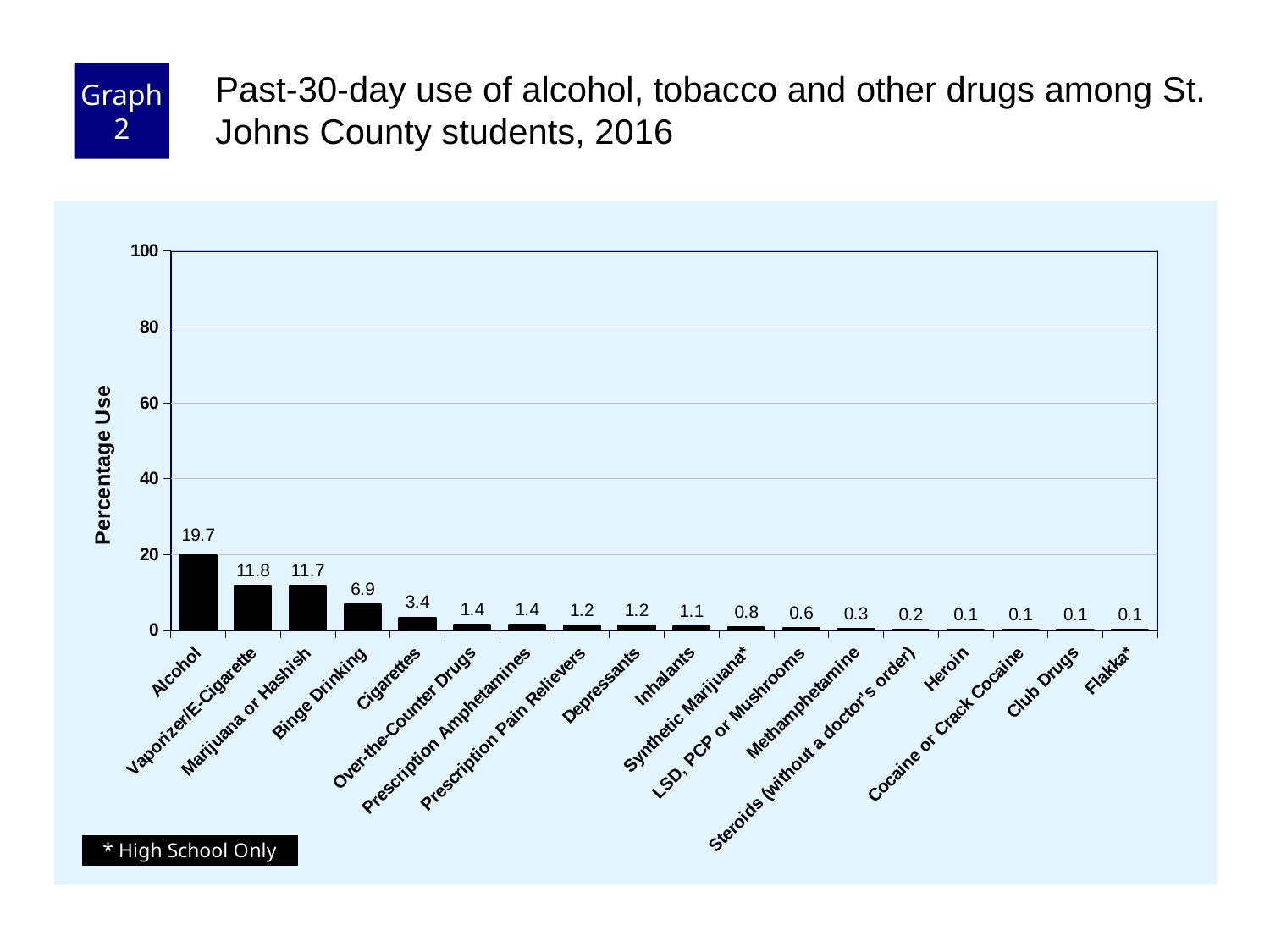
What is the percentage use for Cigarettes? 3.4 What is the difference in percentage use between Binge Drinking and Cigarettes? 3.5 What is the lowest percentage use value shown on the chart? 0.1 What is the percentage use for Binge Drinking? 6.9 How many categories are shown on the chart? 18 What is the percentage use for Alcohol? 19.7 What is the difference in percentage use between Alcohol and Vaporizer/E-Cigarette? 7.9 Which category has the highest percentage use? Alcohol Which has a higher percentage use, Marijuana or Hashish or Binge Drinking? Marijuana or Hashish What is the percentage use for Synthetic Marijuana? 0.8 What type of chart is shown on the slide? Bar chart Is the value for Alcohol greater or less than 20? less